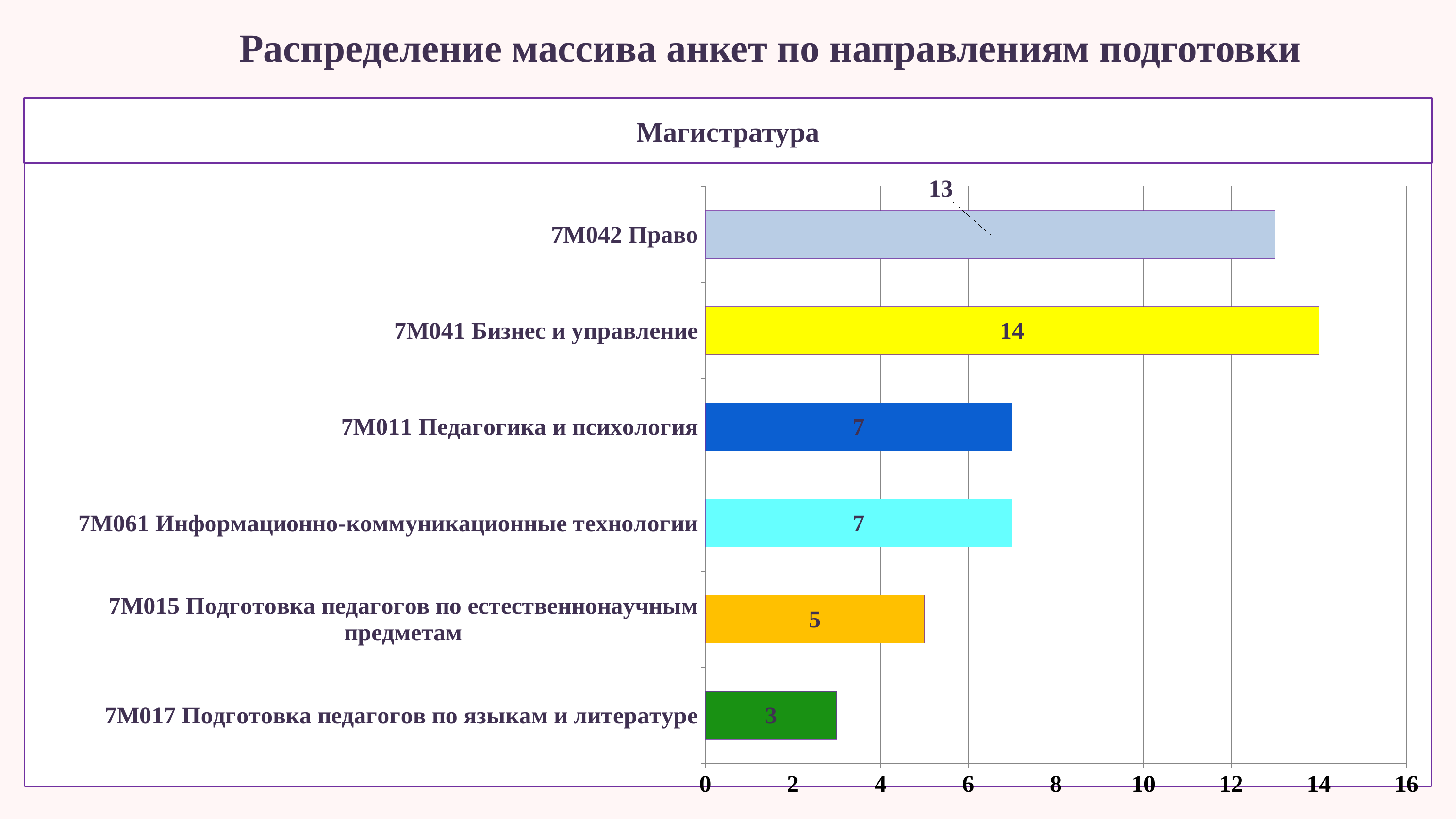
Which is larger, the value for 7М011 Педагогика и психология or the value for 7М015 Подготовка педагогов по естественнонаучным предметам? 7М011 Педагогика и психология Is the value for 7М042 Право greater or less than 10? greater What is the title shown above the chart? Магистратура What is the value for 7М017 Подготовка педагогов по языкам и литературе? 3 What is the value for 7М015 Подготовка педагогов по естественнонаучным предметам? 5 Which category has the lowest value? 7М017 Подготовка педагогов по языкам и литературе What is the difference between the values for 7М041 Бизнес и управление and 7М042 Право? 1 How many categories are shown in the chart? 6 What is the value for 7М042 Право? 13 What kind of chart is shown on the slide? bar chart What is the value for 7М041 Бизнес и управление? 14 Which category has the highest value? 7М041 Бизнес и управление